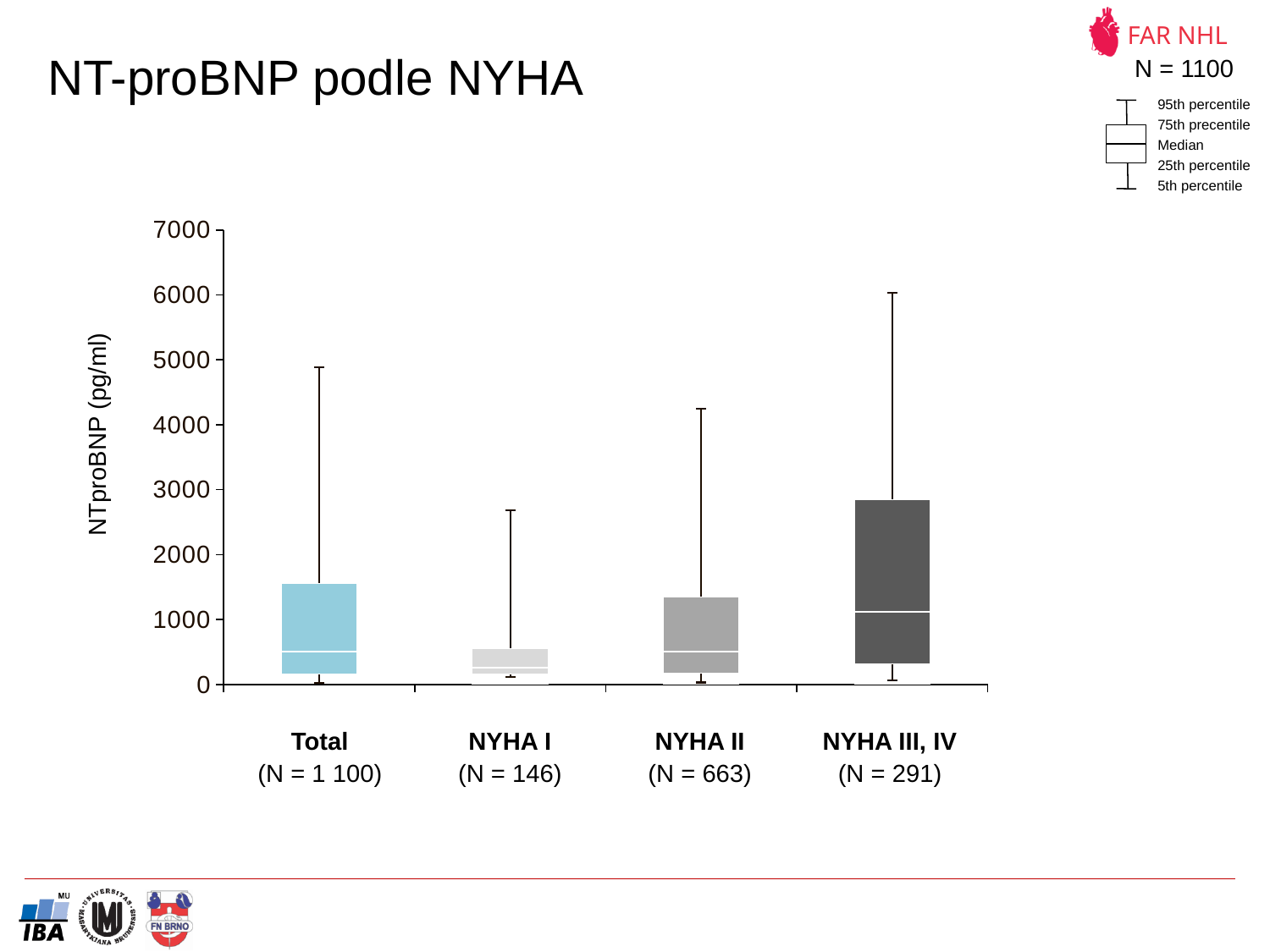
What kind of chart is shown on the slide? Box plot What is the number of patients (N) in the NYHA III, IV group? 291 Is the 95th percentile of NT-proBNP for NYHA I greater or less than 3000? less Is the median NT-proBNP for NYHA III, IV greater or less than 1000? greater Which group has the lowest median NT-proBNP? NYHA I Which group has the highest median NT-proBNP? NYHA III, IV How many groups are plotted along the x axis? 4 What is the number of patients (N) in the NYHA I group? 146 Is the 95th percentile of NT-proBNP for NYHA III, IV greater or less than 5000? greater What is the number of patients (N) in the NYHA II group? 663 What is the label of the y axis? NTproBNP (pg/ml)